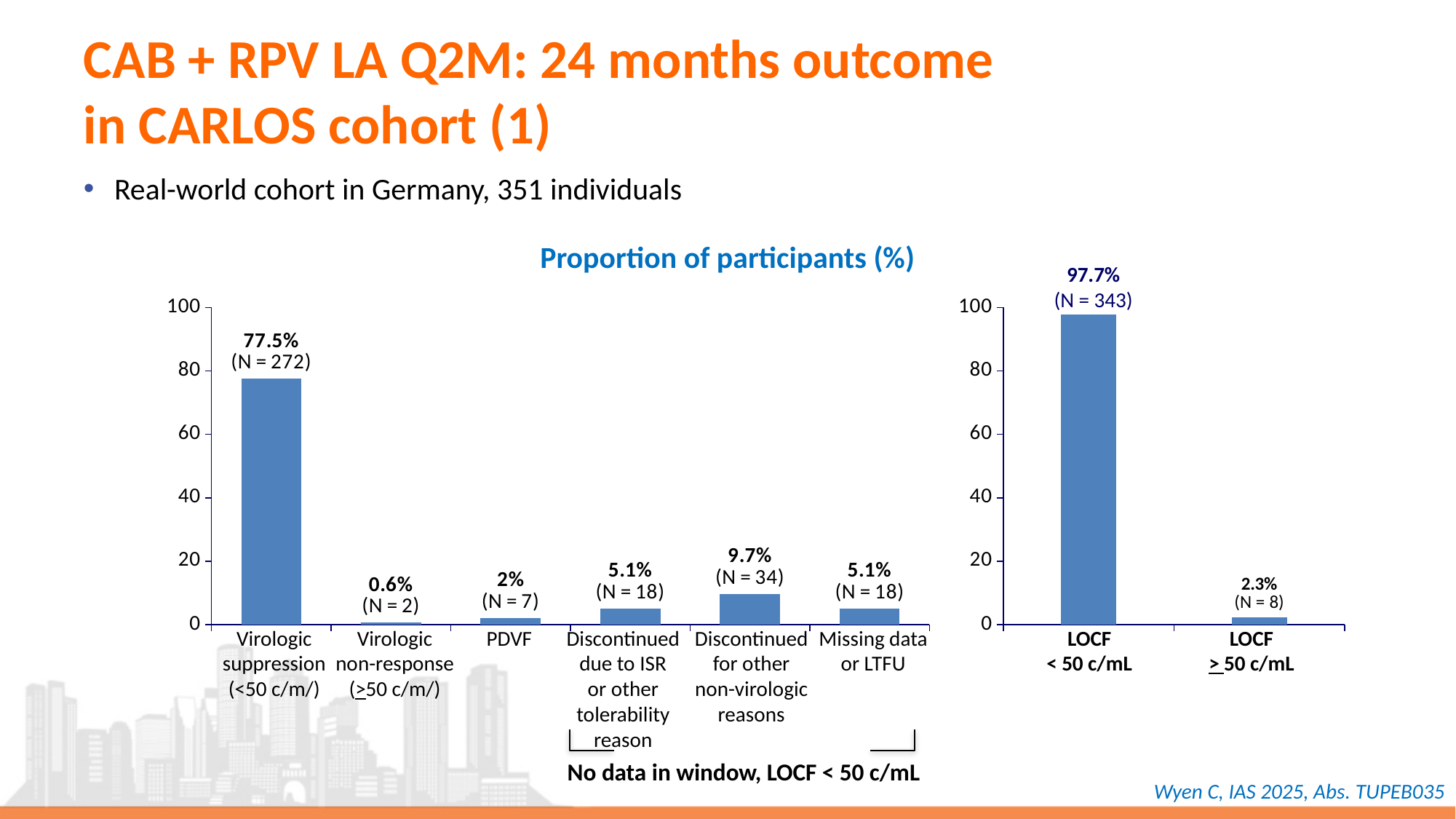
In the left chart, what is the value for Virologic suppression (<50 c/m/)? 77.5% In the right chart, what is the difference between the values for LOCF < 50 c/mL and LOCF > 50 c/mL? 95.4% In the right chart, what is the value for LOCF < 50 c/mL? 97.7% In the left chart, what is the difference between the values for 'Discontinued for other non-virologic reasons' and 'Discontinued due to ISR or other tolerability reason'? 4.6% In the left chart, what is the value for PDVF? 2% In the left chart, which is larger: the value for PDVF or the value for Missing data or LTFU? Missing data or LTFU What type of chart is used on this slide? Bar chart In the left chart, how many participants (N) are in the 'Discontinued for other non-virologic reasons' category? N = 34 In the right chart, how many participants (N) are in the LOCF > 50 c/mL category? N = 8 In the left chart, which category has the highest value? Virologic suppression (<50 c/m/) In the left chart, which category has the lowest value? Virologic non-response (>50 c/m/) How many categories are shown in the left chart? 6